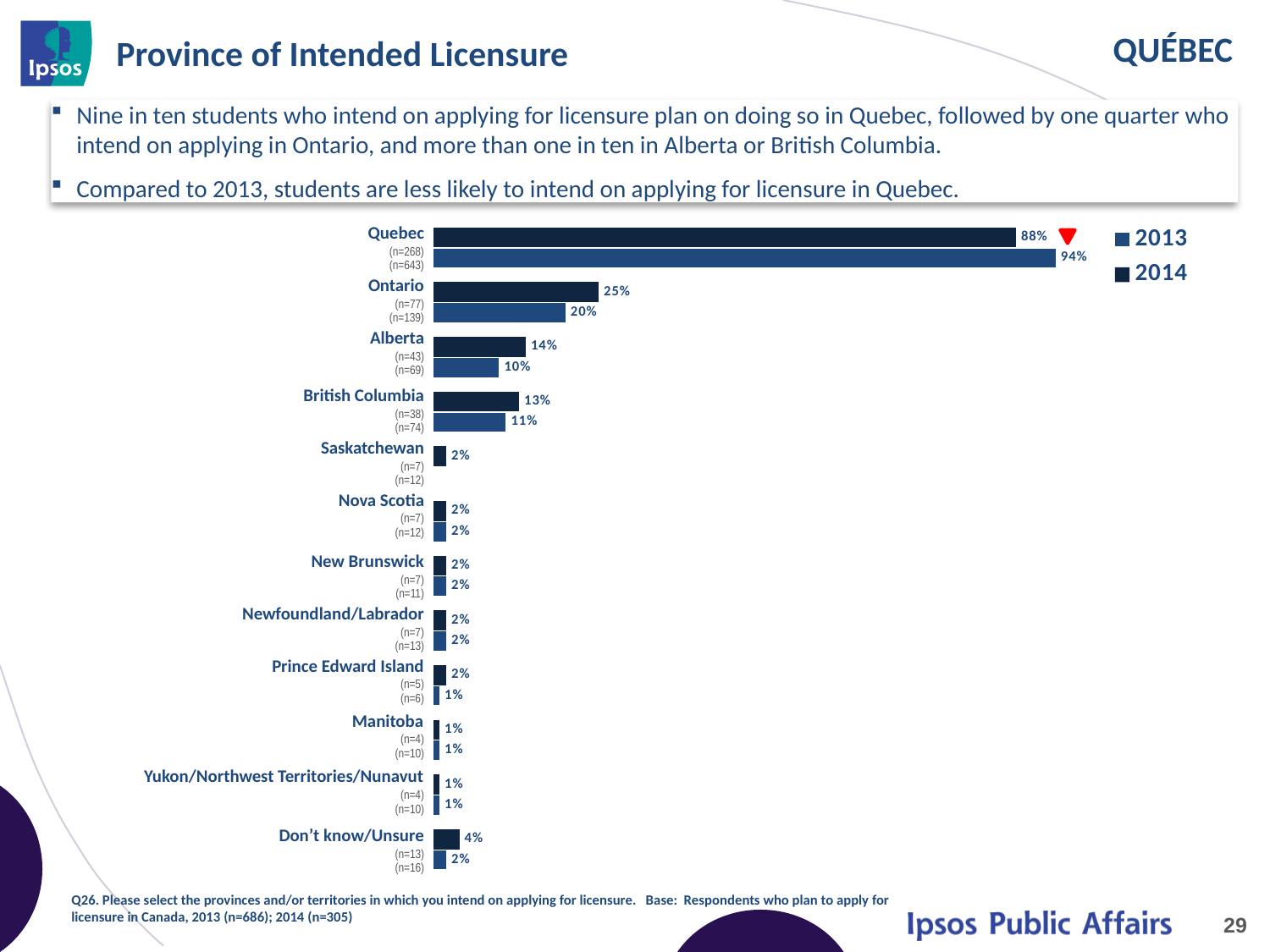
How many provinces/territories or response categories are shown on the chart's vertical axis? 12 What are the two series named in the chart legend? 2013 and 2014 What is the value of the upper bar for Ontario (n=77)? 25% What kind of chart is shown on the slide? Bar chart Which category has the highest value on the chart? Quebec Which is larger: the upper bar for Alberta or the upper bar for British Columbia? Alberta (14%) What is the value of the lower bar for Alberta (n=69)? 10% How many series does the chart legend list? 2 What is the value of the upper bar for Don't know/Unsure (n=13)? 4% What is the difference between the two Quebec bars (94% and 88%)? 6 percentage points What is the value of the lower bar for Quebec (n=643)? 94% What is the value of the upper bar for Quebec (n=268)? 88%